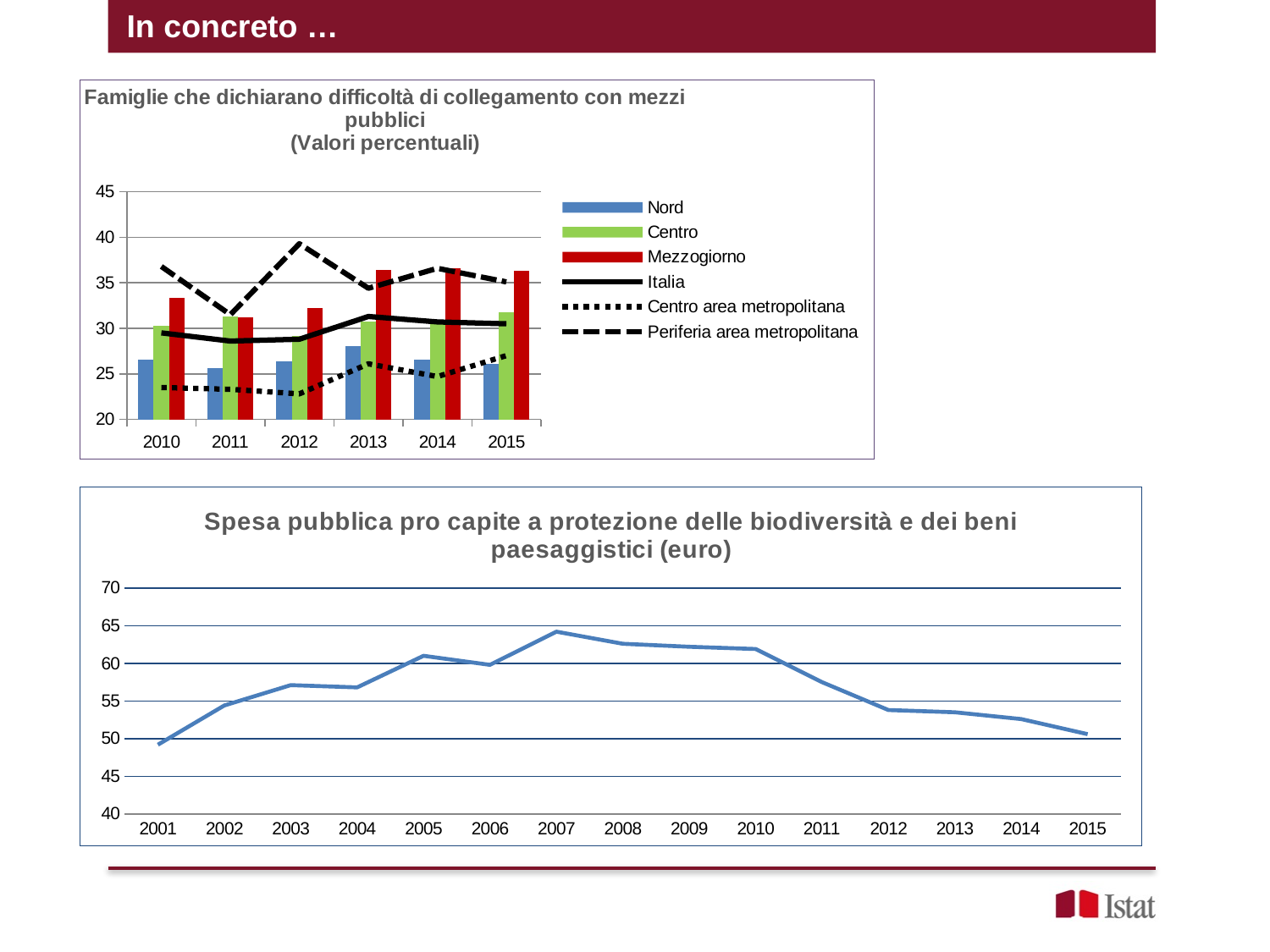
In the bottom chart (Spesa pubblica pro capite a protezione delle biodiversità e dei beni paesaggistici), which year has the highest value? 2007 In the top chart (Famiglie che dichiarano difficoltà di collegamento con mezzi pubblici), is the value for Mezzogiorno in 2013 greater or less than 35? greater In the top chart (Famiglie che dichiarano difficoltà di collegamento con mezzi pubblici), which region's bar is the highest in 2010? Mezzogiorno In the top chart (Famiglie che dichiarano difficoltà di collegamento con mezzi pubblici), how many series does the legend list? 6 In the bottom chart (Spesa pubblica pro capite a protezione delle biodiversità e dei beni paesaggistici), do the values rise or fall from 2010 to 2015? fall In the top chart (Famiglie che dichiarano difficoltà di collegamento con mezzi pubblici), how many years are shown on the x axis? 6 In the top chart (Famiglie che dichiarano difficoltà di collegamento con mezzi pubblici), which region's bar is the lowest in 2013? Nord In the bottom chart (Spesa pubblica pro capite a protezione delle biodiversità e dei beni paesaggistici), is the value for 2012 greater or less than 55? less In the top chart (Famiglie che dichiarano difficoltà di collegamento con mezzi pubblici), which series is drawn as a dashed line? Periferia area metropolitana What kind of chart is the bottom chart (Spesa pubblica pro capite a protezione delle biodiversità e dei beni paesaggistici)? line chart In the bottom chart (Spesa pubblica pro capite a protezione delle biodiversità e dei beni paesaggistici), which year has the lowest value? 2001 In the top chart (Famiglie che dichiarano difficoltà di collegamento con mezzi pubblici), is the value for Centro area metropolitana in 2010 greater or less than 25? less